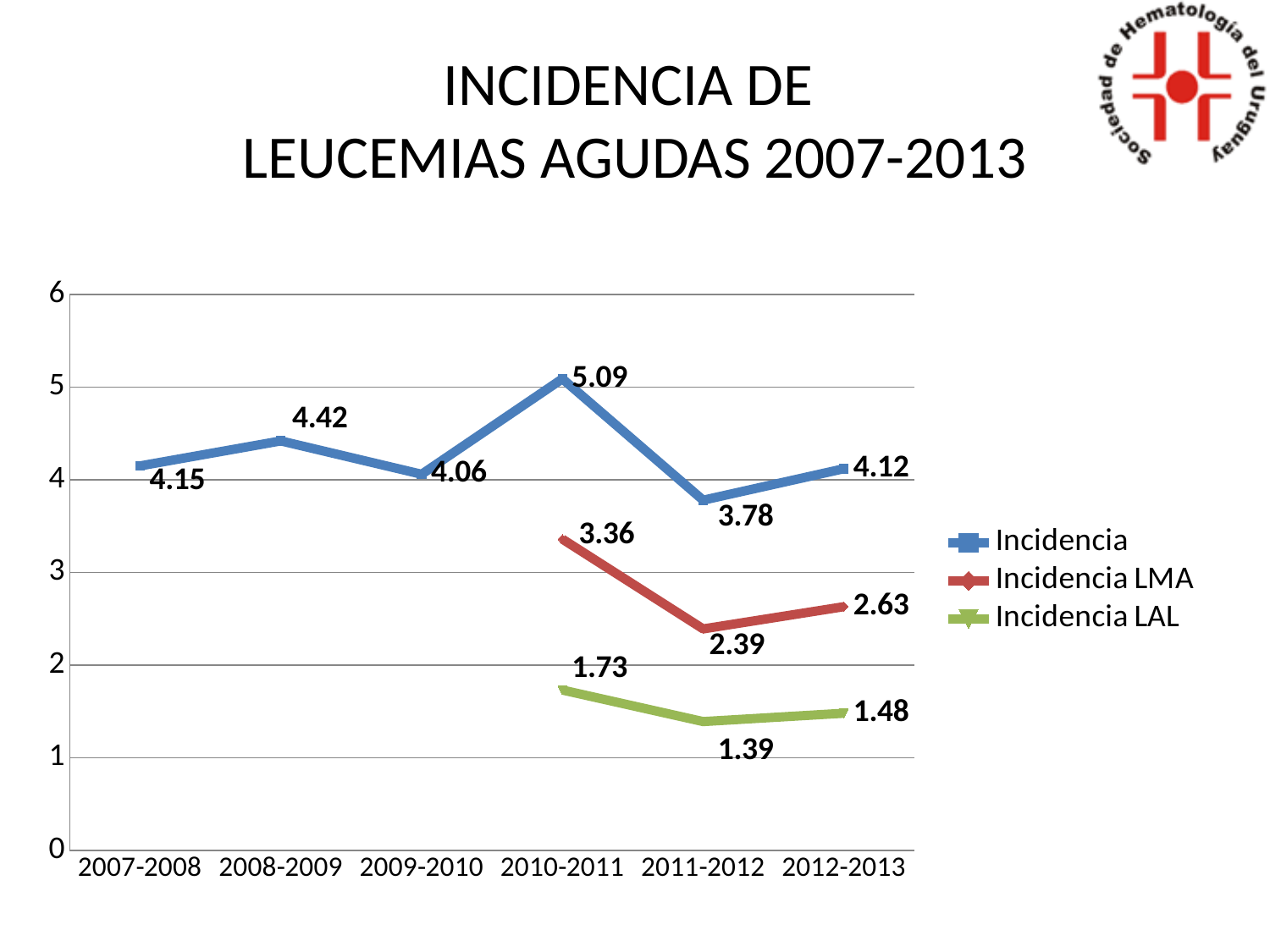
What is the value of the Incidencia series for 2010-2011? 5.09 In which period is the Incidencia series lowest? 2011-2012 What is the difference between the Incidencia values for 2010-2011 and 2011-2012? 1.31 What colour is the Incidencia LMA line? Red In which period is the Incidencia series highest? 2010-2011 How many series does the legend list? 3 Does the Incidencia LAL series rise or fall from 2010-2011 to 2011-2012? Fall Which is larger, the Incidencia LMA value for 2010-2011 or for 2012-2013? 2010-2011 How many periods are shown on the x axis? 6 What is the value of the Incidencia LAL series for 2012-2013? 1.48 What is the value of the Incidencia LMA series for 2011-2012? 2.39 What kind of chart is shown on the slide? Line chart